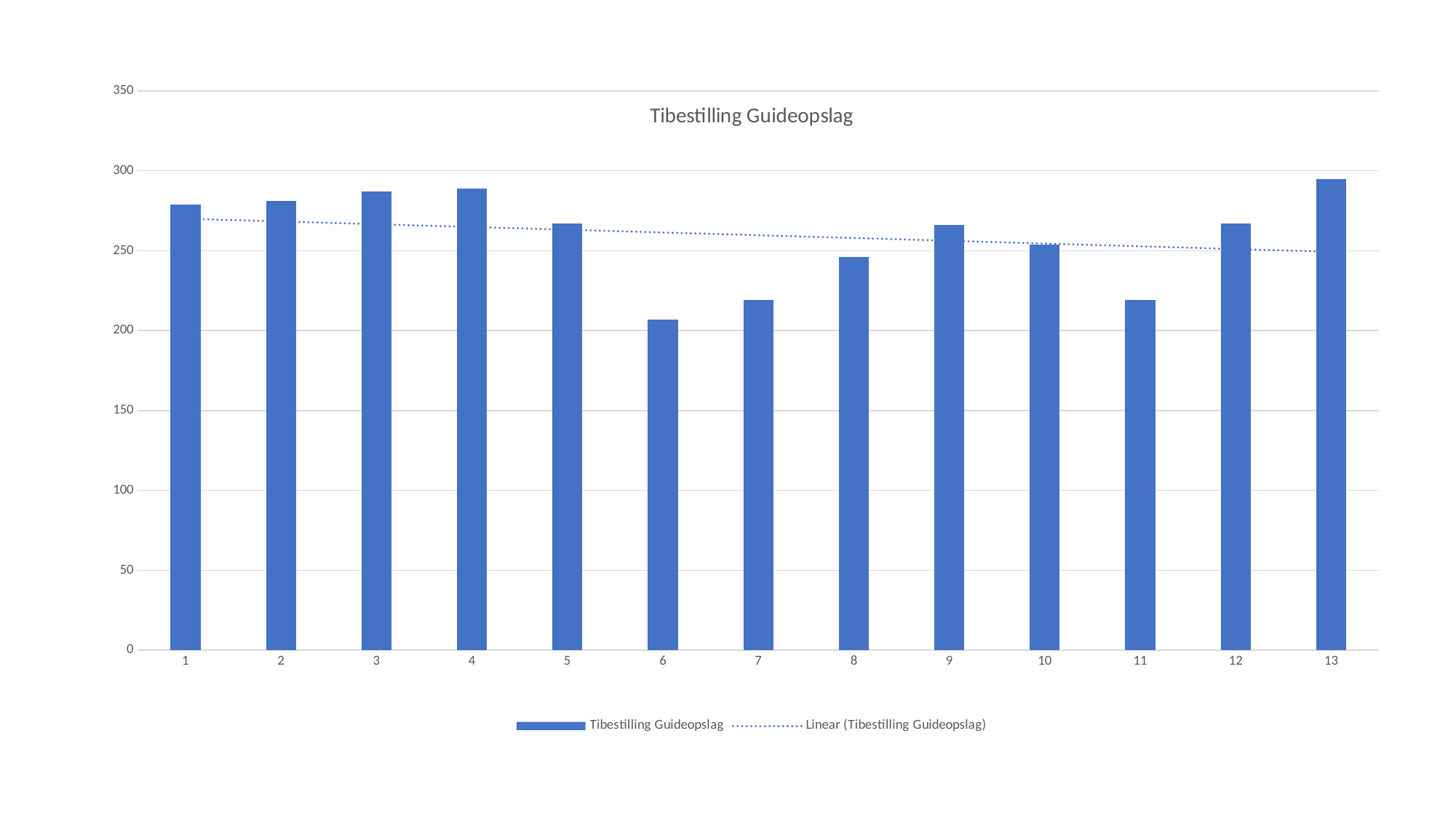
Which category has the highest bar? 13 What is the title of the chart? Tibestilling Guideopslag Is the value for category 3 greater or less than 250? greater Is the value for category 6 greater or less than 250? less Which category has the lowest bar? 6 Is the value for category 7 greater or less than 250? less Does the dotted linear trendline rise or fall from left to right? fall How many entries does the legend list? 2 What kind of chart is shown on the slide? bar chart How many categories are shown on the x axis? 13 Which is larger, the value for category 1 or the value for category 5? category 1